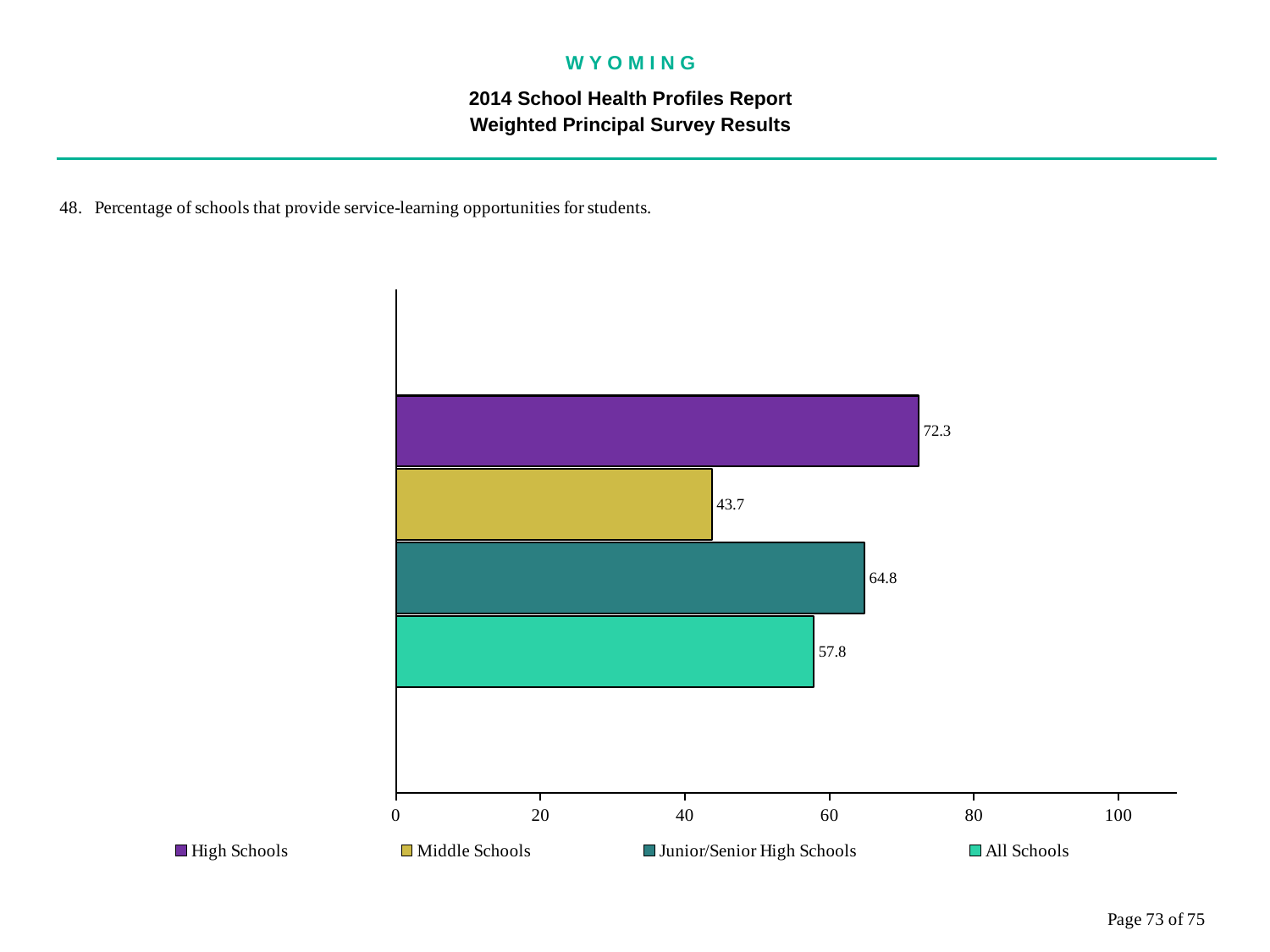
What is the value for Junior/Senior High Schools? 64.8 What kind of chart is shown on the slide? bar chart Which is larger, the value for Junior/Senior High Schools or the value for All Schools? Junior/Senior High Schools Which school type has the highest percentage of schools providing service-learning opportunities? High Schools What colour is the bar for All Schools? green What is the value for Middle Schools? 43.7 What is the difference between the values for High Schools and Middle Schools? 28.6 What is the value for High Schools? 72.3 Is the value for Middle Schools greater or less than 60? less What is the value for All Schools? 57.8 Which school type has the lowest percentage of schools providing service-learning opportunities? Middle Schools How many series does the legend list? 4